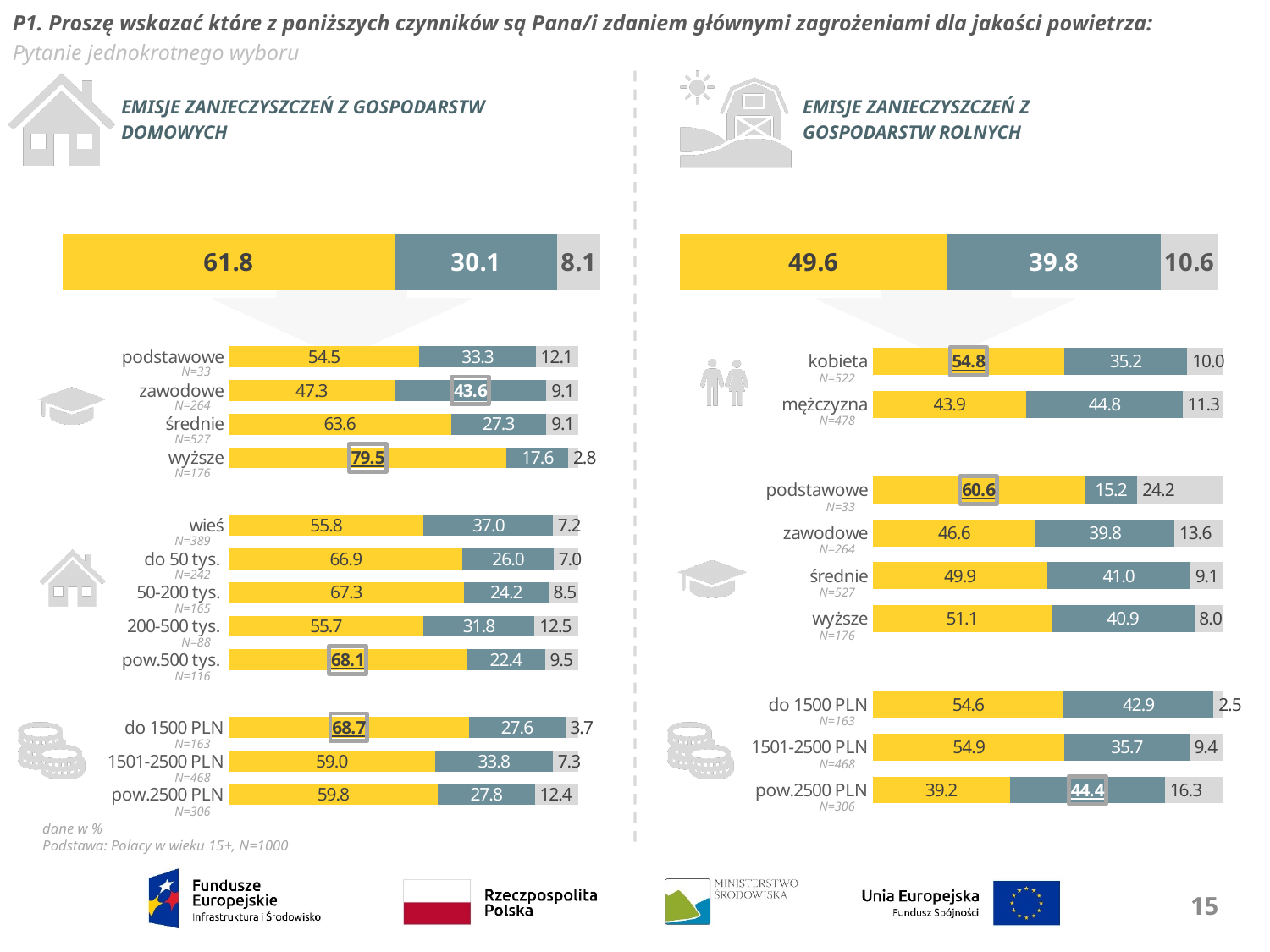
In the chart titled 'EMISJE ZANIECZYSZCZEŃ Z GOSPODARSTW DOMOWYCH', what is the difference between the yellow values for 'wyższe' and 'podstawowe'? 25.0 In the chart titled 'EMISJE ZANIECZYSZCZEŃ Z GOSPODARSTW ROLNYCH', which income category has the lowest yellow value? pow.2500 PLN In the chart titled 'EMISJE ZANIECZYSZCZEŃ Z GOSPODARSTW ROLNYCH', which has a larger yellow value, 'kobieta' or 'mężczyzna'? kobieta In the chart titled 'EMISJE ZANIECZYSZCZEŃ Z GOSPODARSTW DOMOWYCH', how many place-of-residence categories (wieś to pow.500 tys.) are shown? 5 In the chart titled 'EMISJE ZANIECZYSZCZEŃ Z GOSPODARSTW DOMOWYCH', what is the value of the yellow segment in the overall bar at the top? 61.8 In the chart titled 'EMISJE ZANIECZYSZCZEŃ Z GOSPODARSTW DOMOWYCH', what is the yellow value for 'wyższe'? 79.5 In the chart titled 'EMISJE ZANIECZYSZCZEŃ Z GOSPODARSTW ROLNYCH', what is the yellow value for 'kobieta'? 54.8 In the chart titled 'EMISJE ZANIECZYSZCZEŃ Z GOSPODARSTW DOMOWYCH', which education category has the highest yellow value? wyższe In the chart titled 'EMISJE ZANIECZYSZCZEŃ Z GOSPODARSTW ROLNYCH', what is the grey value for 'pow.2500 PLN'? 16.3 In the chart titled 'EMISJE ZANIECZYSZCZEŃ Z GOSPODARSTW ROLNYCH', what is the value of the grey segment in the overall bar at the top? 10.6 What type of chart is used on this slide? Stacked bar chart In the chart titled 'EMISJE ZANIECZYSZCZEŃ Z GOSPODARSTW ROLNYCH', what is the total of the three segments for 'podstawowe'? 100.0